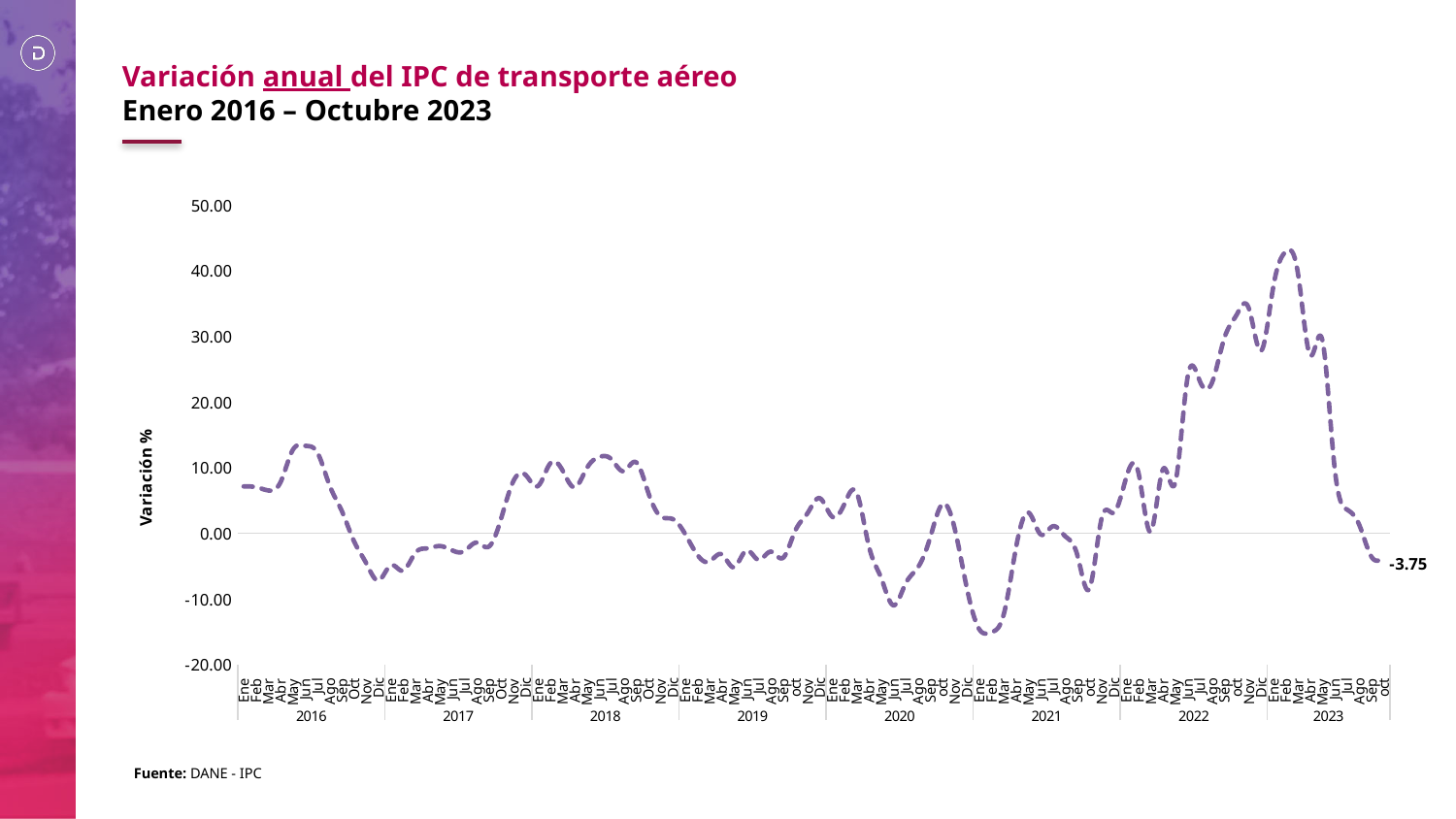
Is the value for June 2016 greater or less than 10.00? greater Is the lowest value of the series, reached in early 2021, greater or less than -10.00? less What is the title of the chart on the slide? Variación anual del IPC de transporte aéreo, Enero 2016 – Octubre 2023 Is the peak value reached in early 2023 greater or less than 40.00? greater What is the value of the data label shown at the end of the line, for October 2023? -3.75 How many years are labelled along the horizontal axis? 8 In which year does the series reach its highest value? 2023 In which year does the series reach its lowest value? 2021 What kind of chart is shown on the slide? Line chart What is the label of the vertical axis? Variación % Does the series rise or fall between February 2023 and October 2023? Fall